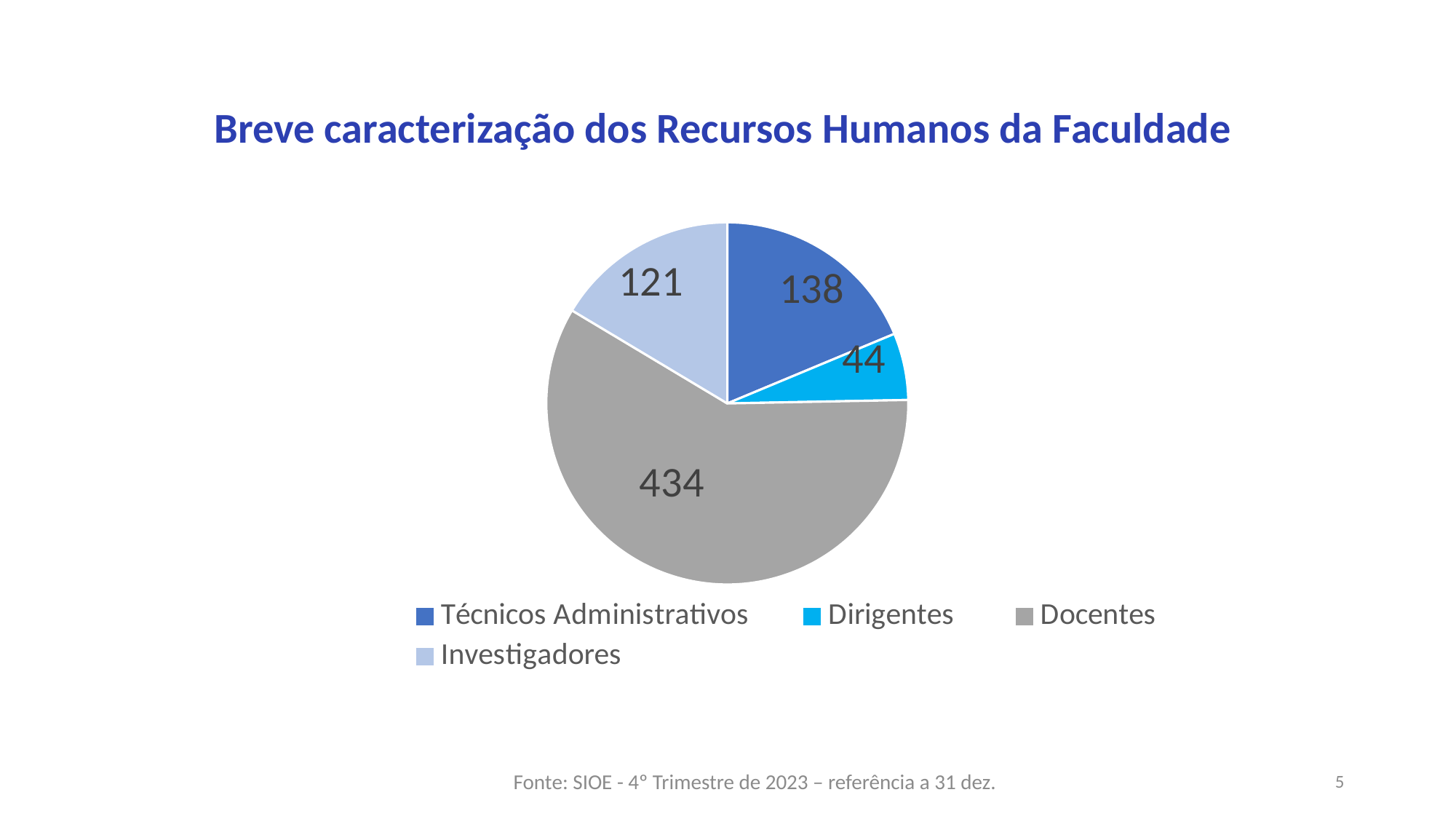
What is the difference between the values for Docentes and Técnicos Administrativos? 296 What is the value for Técnicos Administrativos? 138 What is the value for Docentes? 434 What is the difference between the values for Técnicos Administrativos and Investigadores? 17 Which category has the largest slice? Docentes Which category has the smallest slice? Dirigentes What is the value for Investigadores? 121 What type of chart is shown on the slide? pie chart How many categories does the pie chart have? 4 What is the title of the slide containing the chart? Breve caracterização dos Recursos Humanos da Faculdade What is the value for Dirigentes? 44 Which is larger, the value for Investigadores or the value for Dirigentes? Investigadores